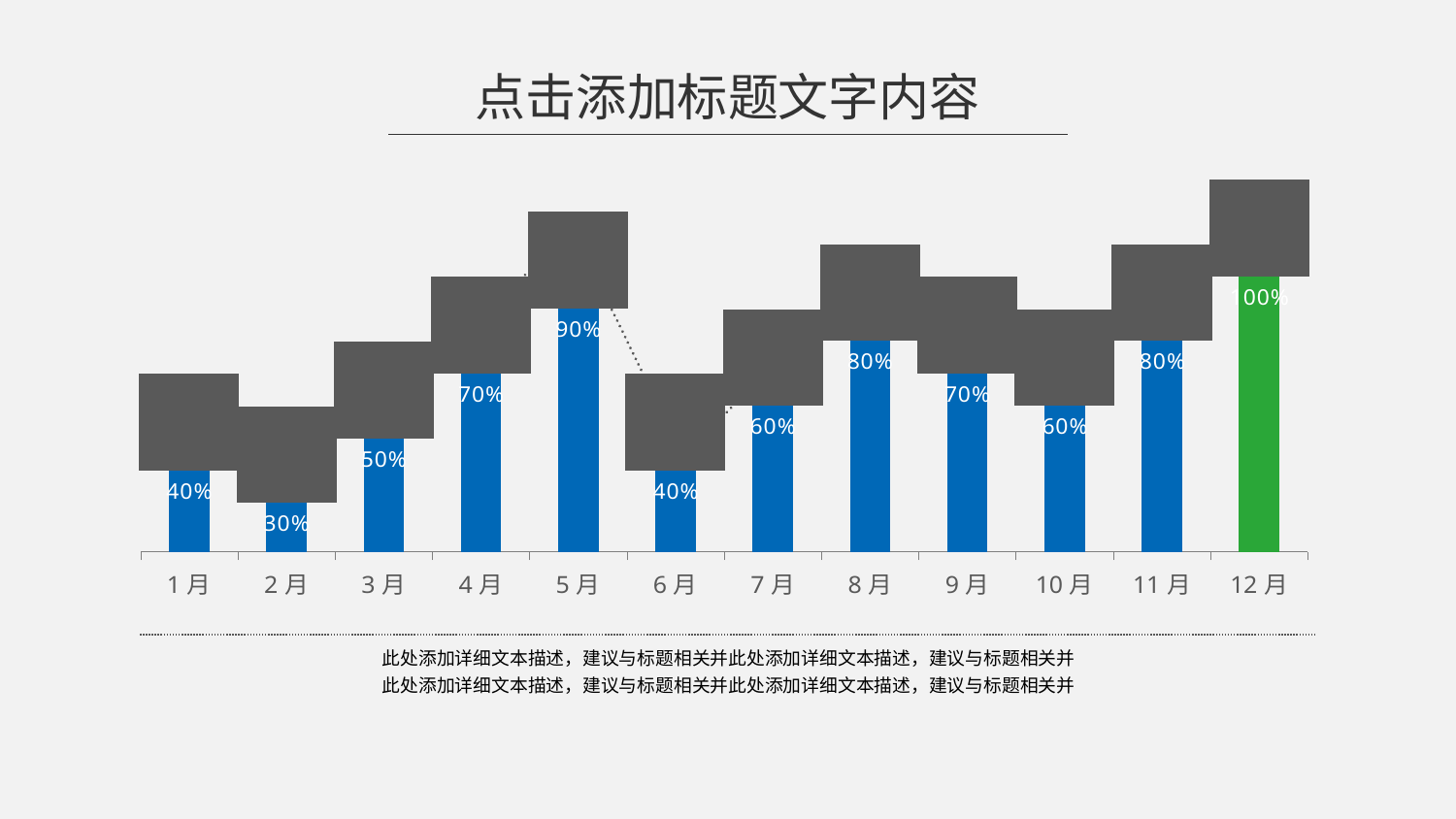
What is the value for 2月? 30% Which is larger, the value for 8月 or the value for 10月? 8月 Which bar is coloured green rather than blue? 12月 What is the value for 5月? 90% Which month has the lowest value? 2月 What is the difference between the values for 5月 and 6月? 50% What is the value for 9月? 70% Which month has the highest value? 12月 Which is larger, the value for 4月 or the value for 7月? 4月 How many months are shown on the x axis? 12 What kind of chart is shown on the slide? Bar chart What is the difference between the values for 12月 and 1月? 60%